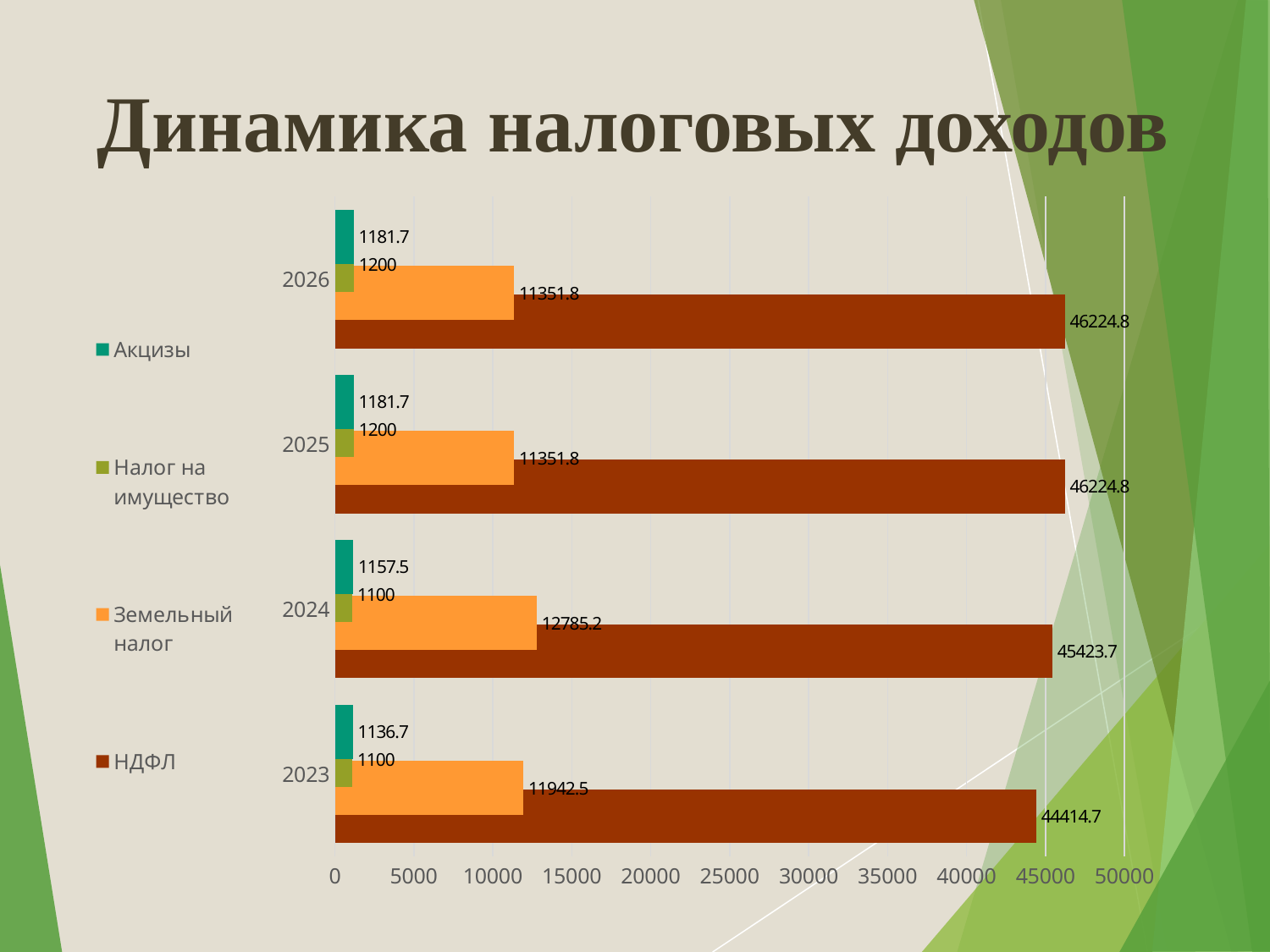
Which is larger in 2024: Акцизы or Налог на имущество? Акцизы What is the value of Акцизы for 2026? 1181.7 How many series does the legend list? 4 What is the value of Налог на имущество for 2025? 1200 Is the value of НДФЛ for 2026 greater or less than 45000? greater How many years are shown on the chart? 4 What type of chart is shown on the slide? Bar chart What is the value of Земельный налог for 2024? 12785.2 What is the value of НДФЛ for 2023? 44414.7 In which year is НДФЛ lowest? 2023 In which year is Земельный налог highest? 2024 What is the difference between НДФЛ in 2024 and НДФЛ in 2023? 1009